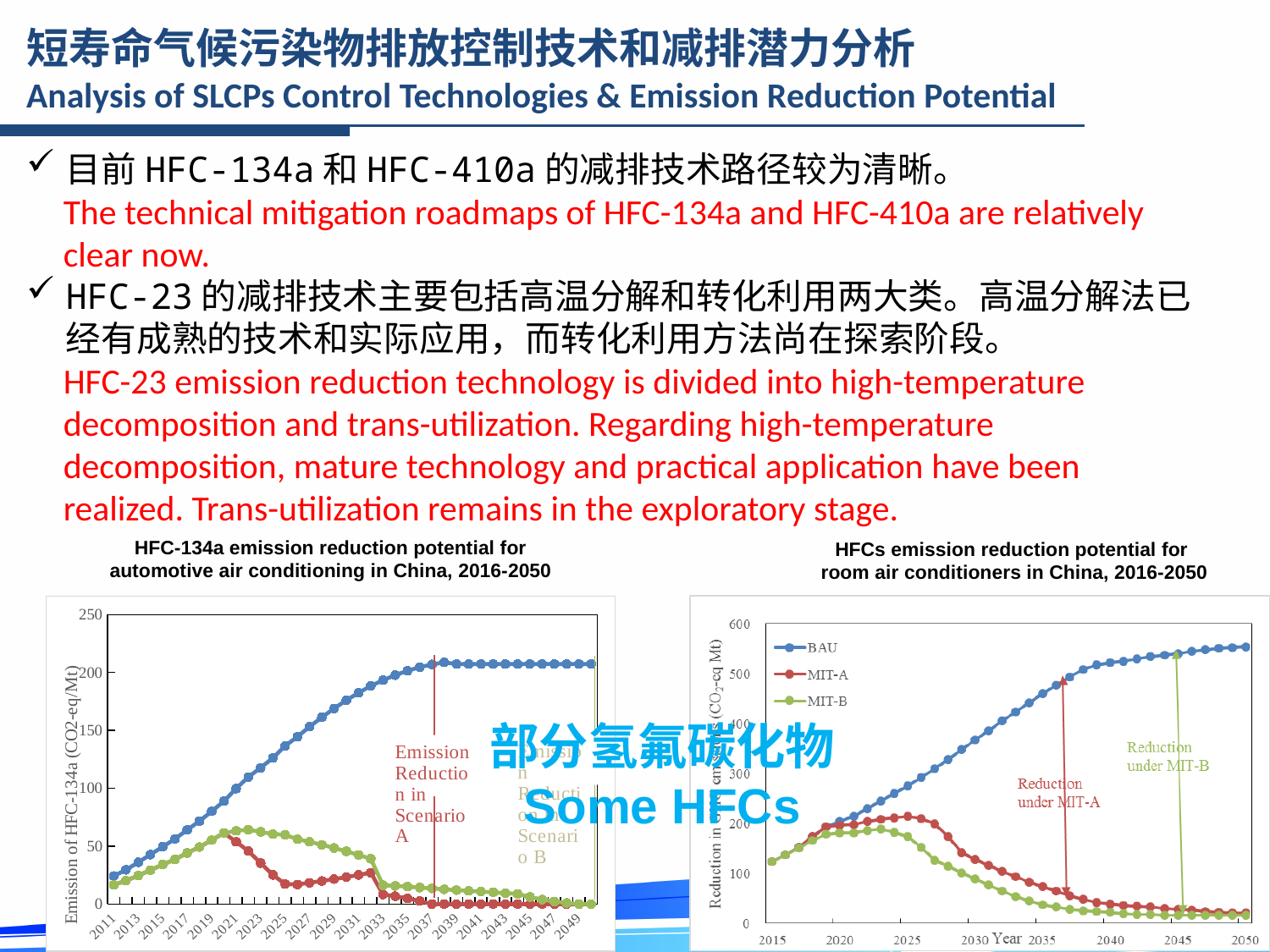
How many series does the legend list in the 'HFCs emission reduction potential for room air conditioners in China, 2016-2050' chart? 3 In the 'HFCs emission reduction potential for room air conditioners in China, 2016-2050' chart, is the BAU value in 2015 greater or less than 200? less In the 'HFCs emission reduction potential for room air conditioners in China, 2016-2050' chart, is the BAU value in 2050 greater or less than 500? greater In the 'HFC-134a emission reduction potential for automotive air conditioning in China, 2016-2050' chart, is the value of the blue series in 2049 greater or less than 200? greater What kind of chart is the 'HFC-134a emission reduction potential for automotive air conditioning in China, 2016-2050' chart? line chart What kind of chart is the 'HFCs emission reduction potential for room air conditioners in China, 2016-2050' chart? line chart In the 'HFCs emission reduction potential for room air conditioners in China, 2016-2050' chart, which series are listed in the legend? BAU, MIT-A, MIT-B In the 'HFCs emission reduction potential for room air conditioners in China, 2016-2050' chart, does the BAU series rise or fall from 2015 to 2050? rise In the 'HFCs emission reduction potential for room air conditioners in China, 2016-2050' chart, does the MIT-B series rise or fall from 2025 to 2050? fall In the 'HFC-134a emission reduction potential for automotive air conditioning in China, 2016-2050' chart, what is the y-axis label? Emission of HFC-134a (CO2-eq/Mt)